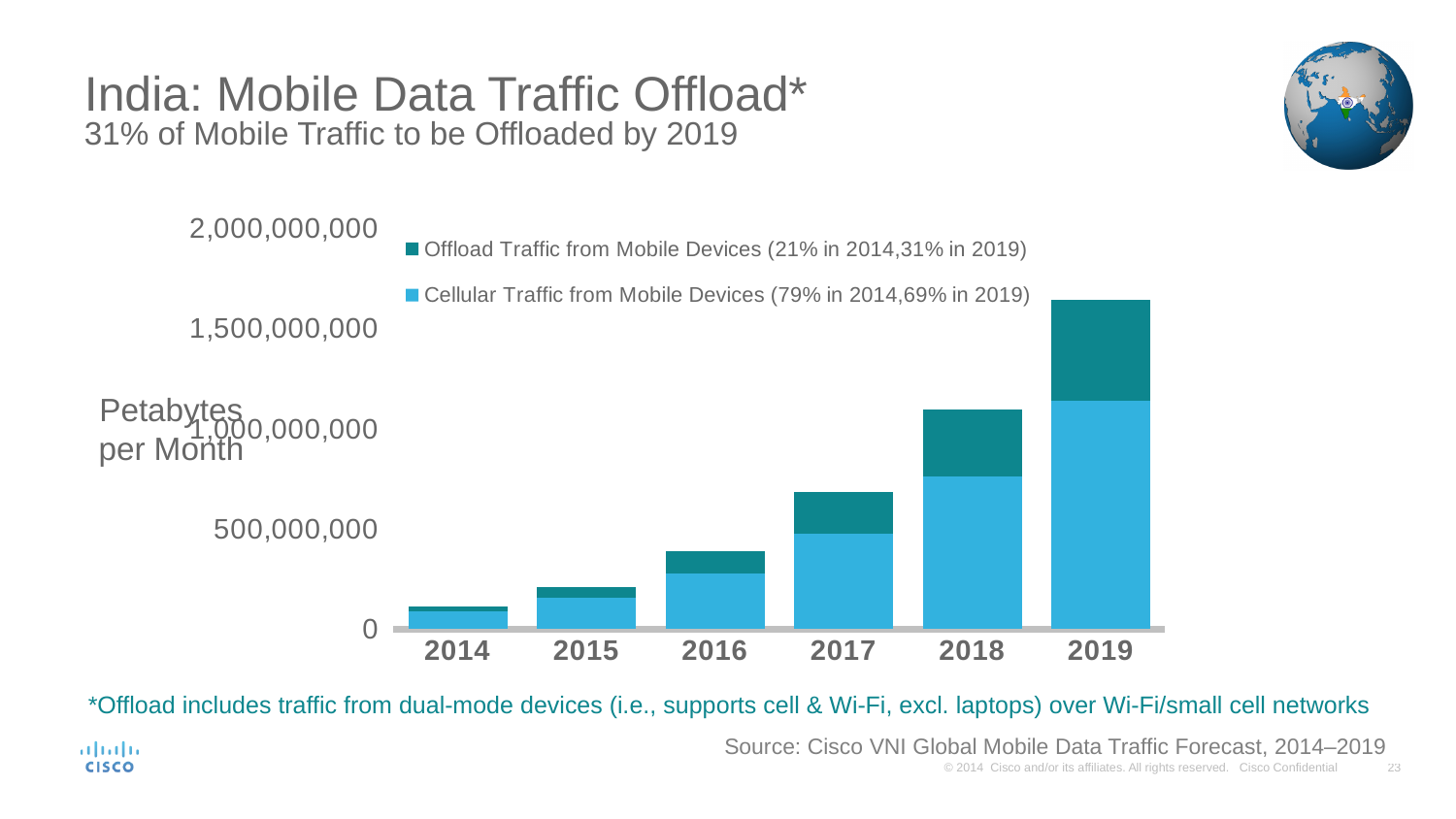
Is the total traffic for 2018 greater or less than 1,000,000,000? greater Which year has the lowest total mobile data traffic in the chart? 2014 How many years are shown on the x axis of the chart? 6 What unit is shown on the y axis label of the chart? Petabytes per Month Is the total traffic for 2016 greater or less than 500,000,000? less Do the total bar heights rise or fall from 2014 to 2019? Rise What kind of chart is shown on the slide? Stacked bar chart Which year has the highest total mobile data traffic in the chart? 2019 Is the total traffic for 2019 greater or less than 1,500,000,000? greater Which is larger in 2018: the total traffic for 2018 or the total traffic for 2017? 2018 How many series does the chart's legend list? 2